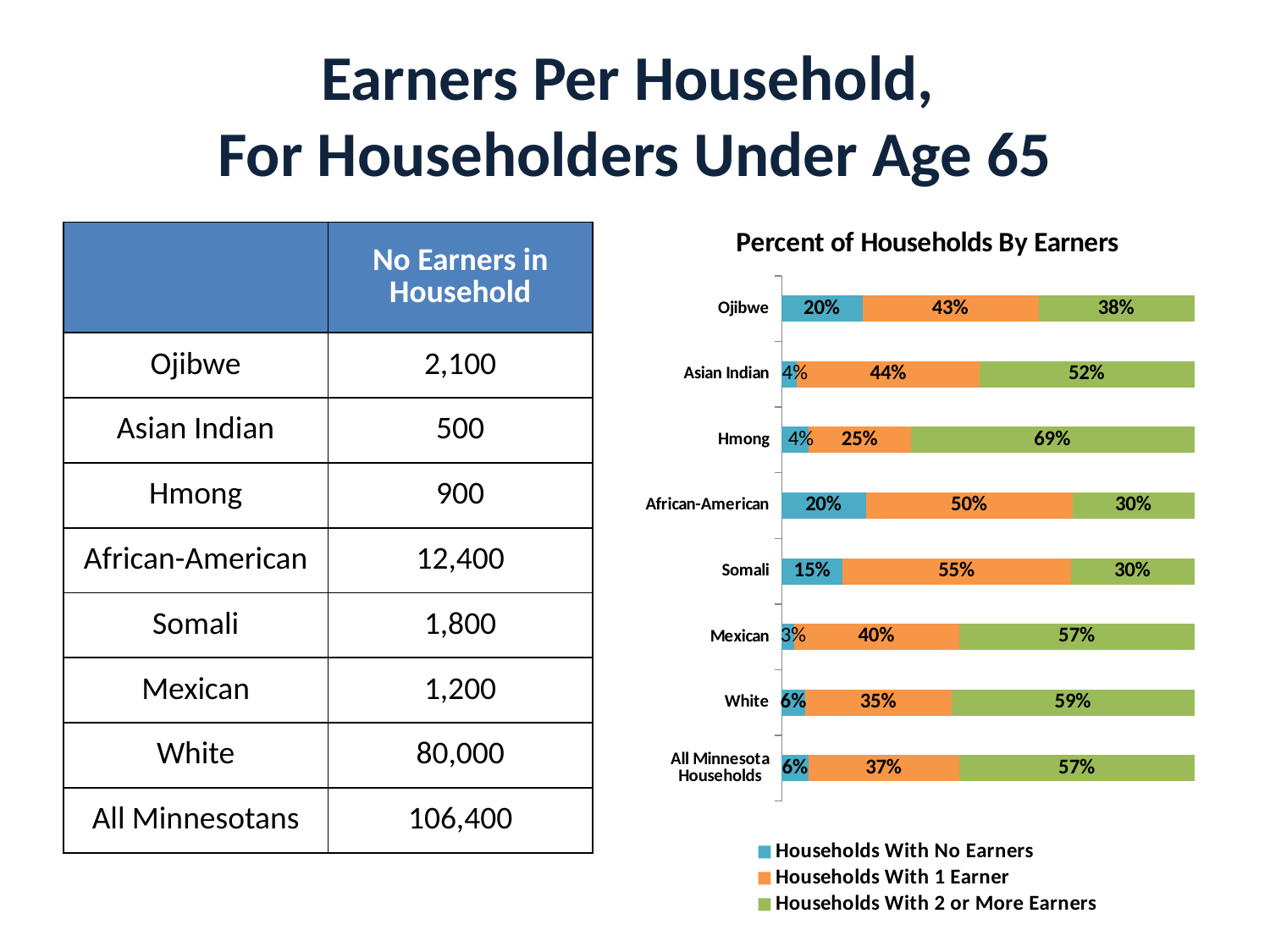
In the 'Percent of Households By Earners' chart, what percentage of Hmong households have 2 or more earners? 69% In the 'Percent of Households By Earners' chart, what is the total of the three segments for the Somali bar? 100% In the 'Percent of Households By Earners' chart, which group has the lowest share of households with no earners? Mexican In the 'Percent of Households By Earners' chart, what percentage of Somali households have 1 earner? 55% In the 'Percent of Households By Earners' chart, what percentage of All Minnesota Households have no earners? 6% What type of chart is 'Percent of Households By Earners'? Stacked bar chart How many series does the legend of the 'Percent of Households By Earners' chart list? 3 In the 'Percent of Households By Earners' chart, which has a larger share of households with 2 or more earners: White or African-American? White In the 'Percent of Households By Earners' chart, which group has the highest share of households with 1 earner? Somali In the 'Percent of Households By Earners' chart, how many percentage points higher is the 1-earner share for Somali households than for Ojibwe households? 12 percentage points In the 'Percent of Households By Earners' chart, which group has the highest share of households with 2 or more earners? Hmong How many groups are shown on the y axis of the 'Percent of Households By Earners' chart? 8